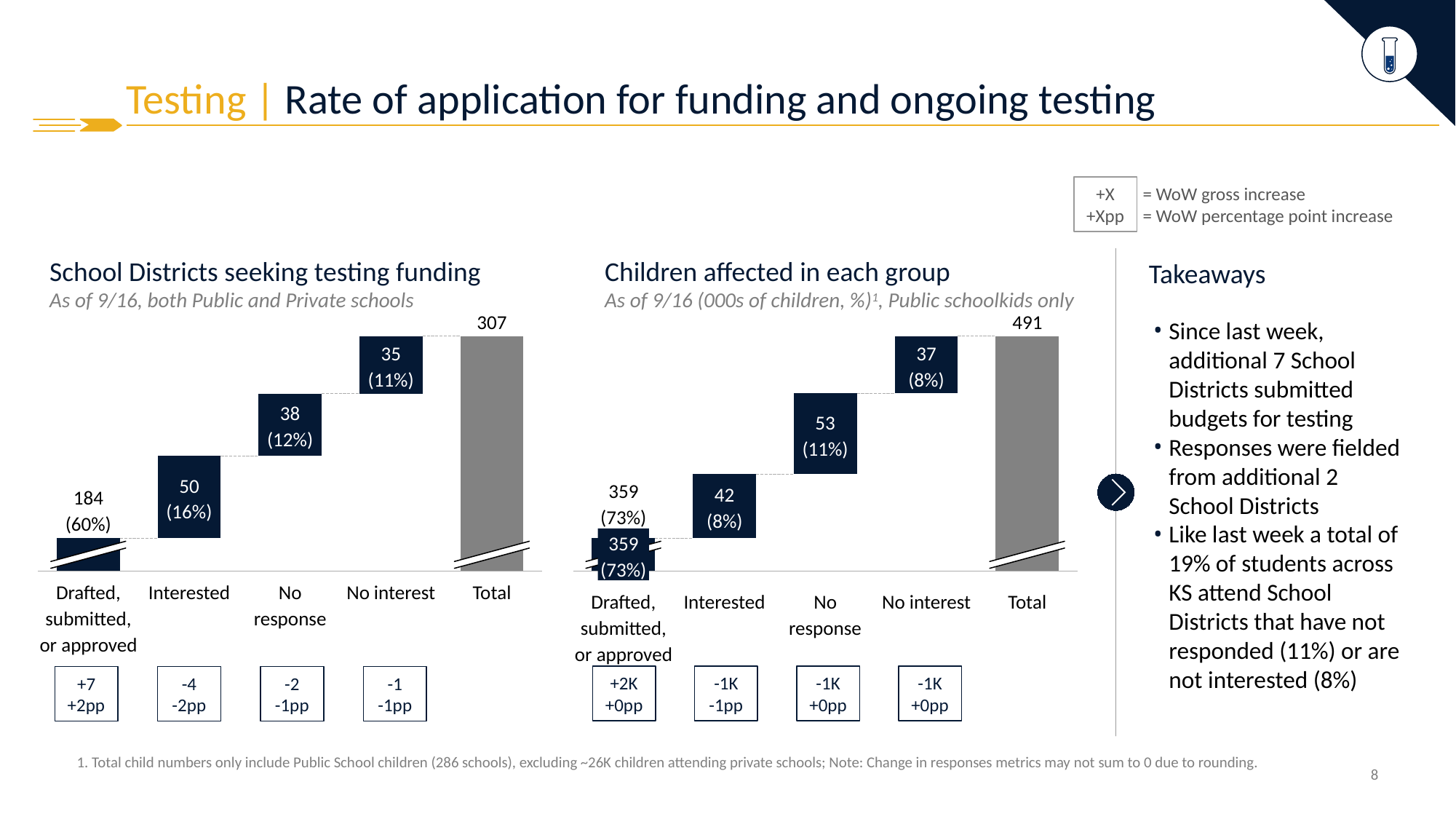
In the 'School Districts seeking testing funding' chart, which category other than Total has the highest value? Drafted, submitted, or approved In the 'Children affected in each group' chart, which is larger, 'Interested' or 'No response'? No response How many categories, including Total, are shown on the x axis of the 'School Districts seeking testing funding' chart? 5 In the 'School Districts seeking testing funding' chart, what is the Total value? 307 In the 'Children affected in each group' chart, what is the value for 'No response'? 53 (11%) What kind of chart is the 'Children affected in each group' chart? Waterfall bar chart In the 'Children affected in each group' chart, what percentage is shown for 'Drafted, submitted, or approved'? 73% What is the subtitle of the 'School Districts seeking testing funding' chart? As of 9/16, both Public and Private schools In the 'Children affected in each group' chart, what is the Total value? 491 In the 'School Districts seeking testing funding' chart, what is the difference between the 'Interested' and 'No response' values? 12 In the 'School Districts seeking testing funding' chart, which category has the lowest value? No interest In the 'School Districts seeking testing funding' chart, what is the value for 'Interested'? 50 (16%)